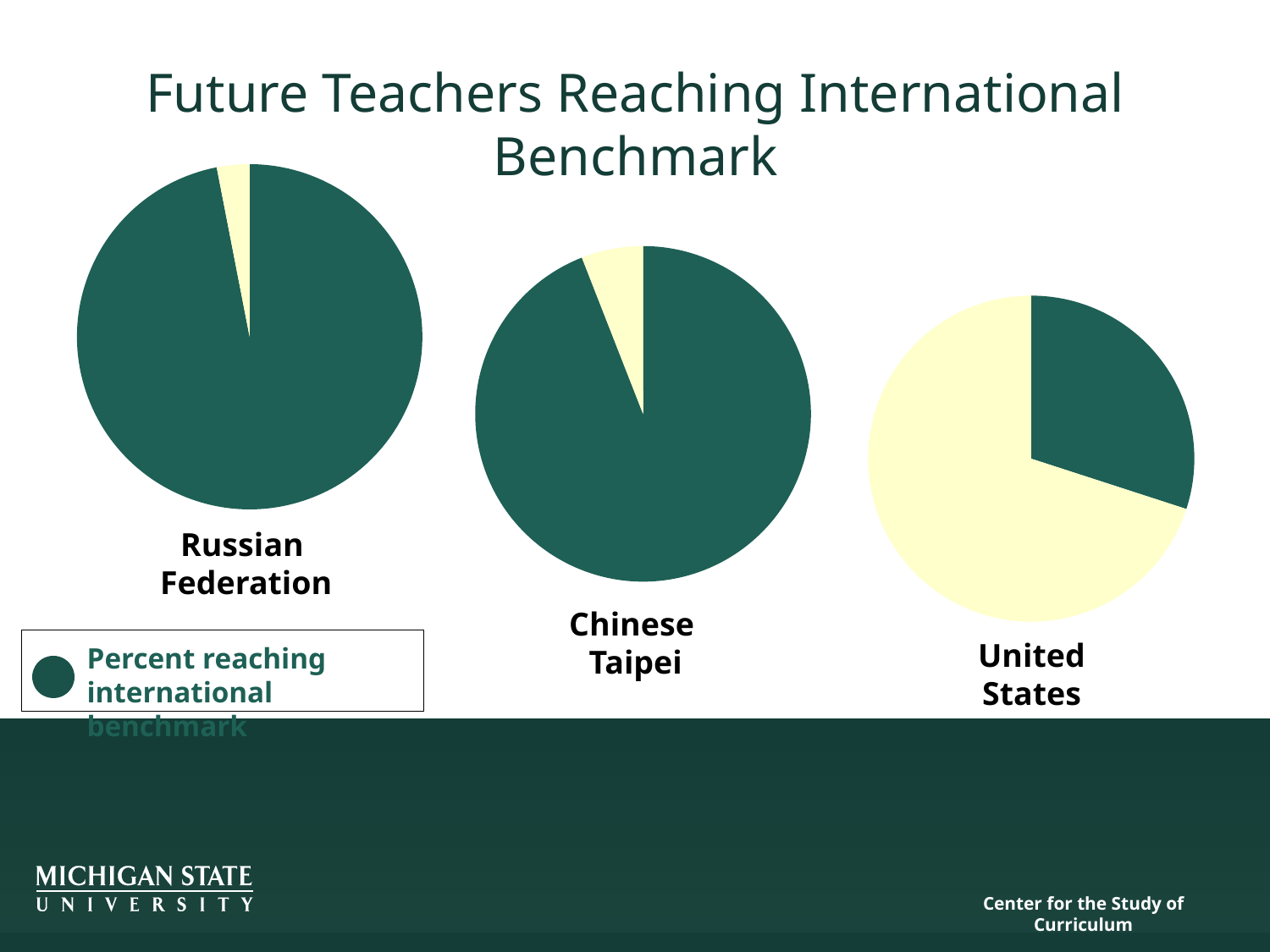
Which country has the smallest share of future teachers reaching the international benchmark? United States How many pie charts are shown on the slide? 3 Which country's pie chart is positioned in the middle of the slide? Chinese Taipei What does the legend say the dark green slice represents? Percent reaching international benchmark What is the title of the slide containing the pie charts? Future Teachers Reaching International Benchmark What kind of chart is used to show the data for each country on this slide? Pie chart Which countries are shown in the pie charts? Russian Federation, Chinese Taipei, United States In which country's pie chart does the share reaching the international benchmark make up less than half of the pie? United States Which has a larger share reaching the international benchmark, the Russian Federation or the United States? Russian Federation Which country has the largest share of future teachers reaching the international benchmark? Russian Federation Which has a larger share reaching the international benchmark, Chinese Taipei or the United States? Chinese Taipei